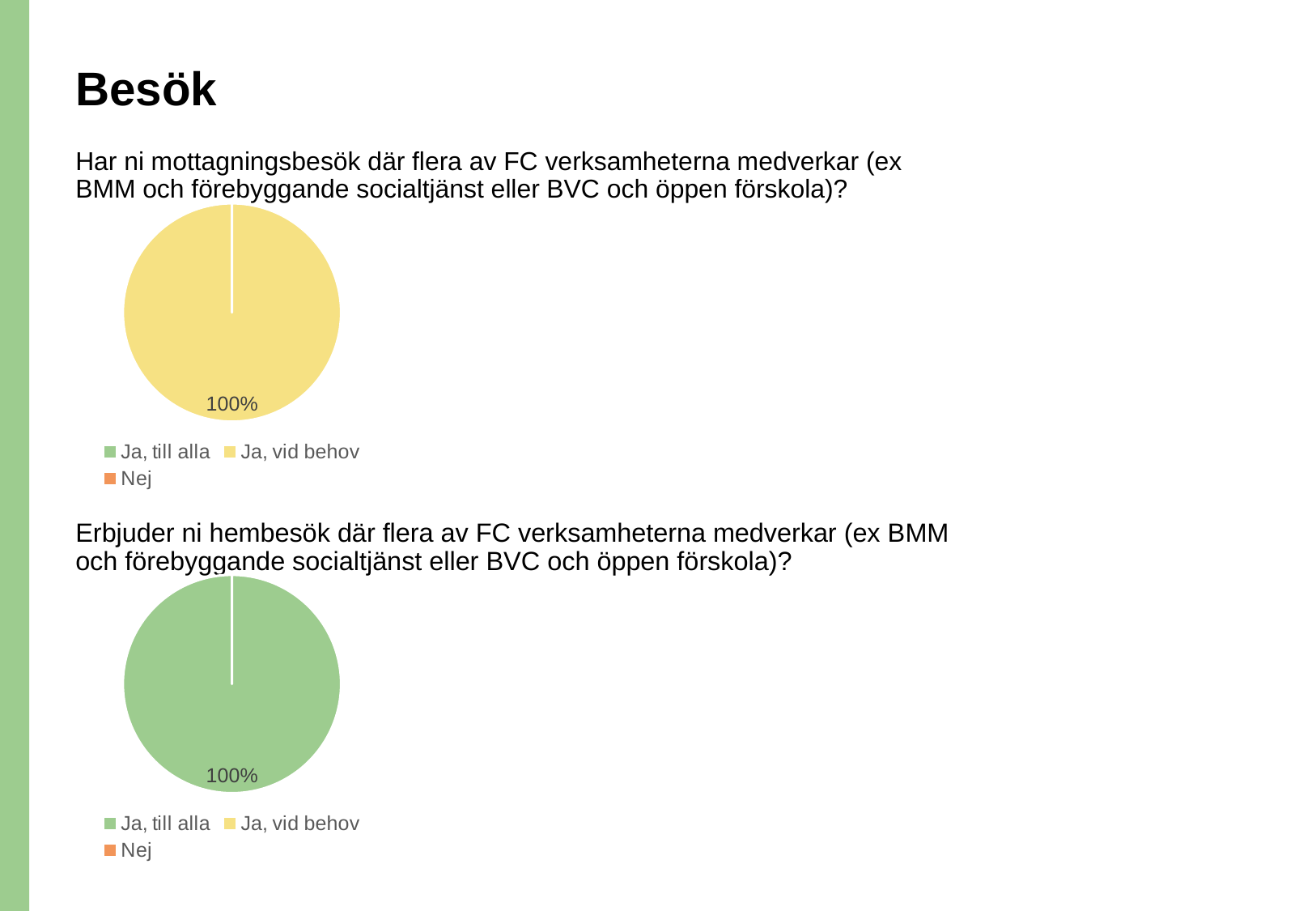
How many entries does the legend of the top pie chart (mottagningsbesök) list? 3 In the top pie chart (mottagningsbesök), which legend category does the single 100% slice belong to, judging by its colour? Ja, vid behov In the bottom pie chart (hembesök), which category has the largest share? Ja, till alla What colour is the slice in the bottom pie chart (hembesök)? green How many entries does the legend of the bottom pie chart (hembesök) list? 3 In the bottom pie chart (hembesök), which legend category does the single 100% slice belong to, judging by its colour? Ja, till alla What kind of chart is shown under the question about mottagningsbesök (top chart)? pie chart In the top pie chart (mottagningsbesök), which category has the largest share? Ja, vid behov What kind of chart is shown under the question about hembesök (bottom chart)? pie chart In the top pie chart (mottagningsbesök), what share is shown by the data label? 100% In the bottom pie chart (hembesök), what share is shown by the data label? 100% What is the title of the slide containing the two pie charts? Besök